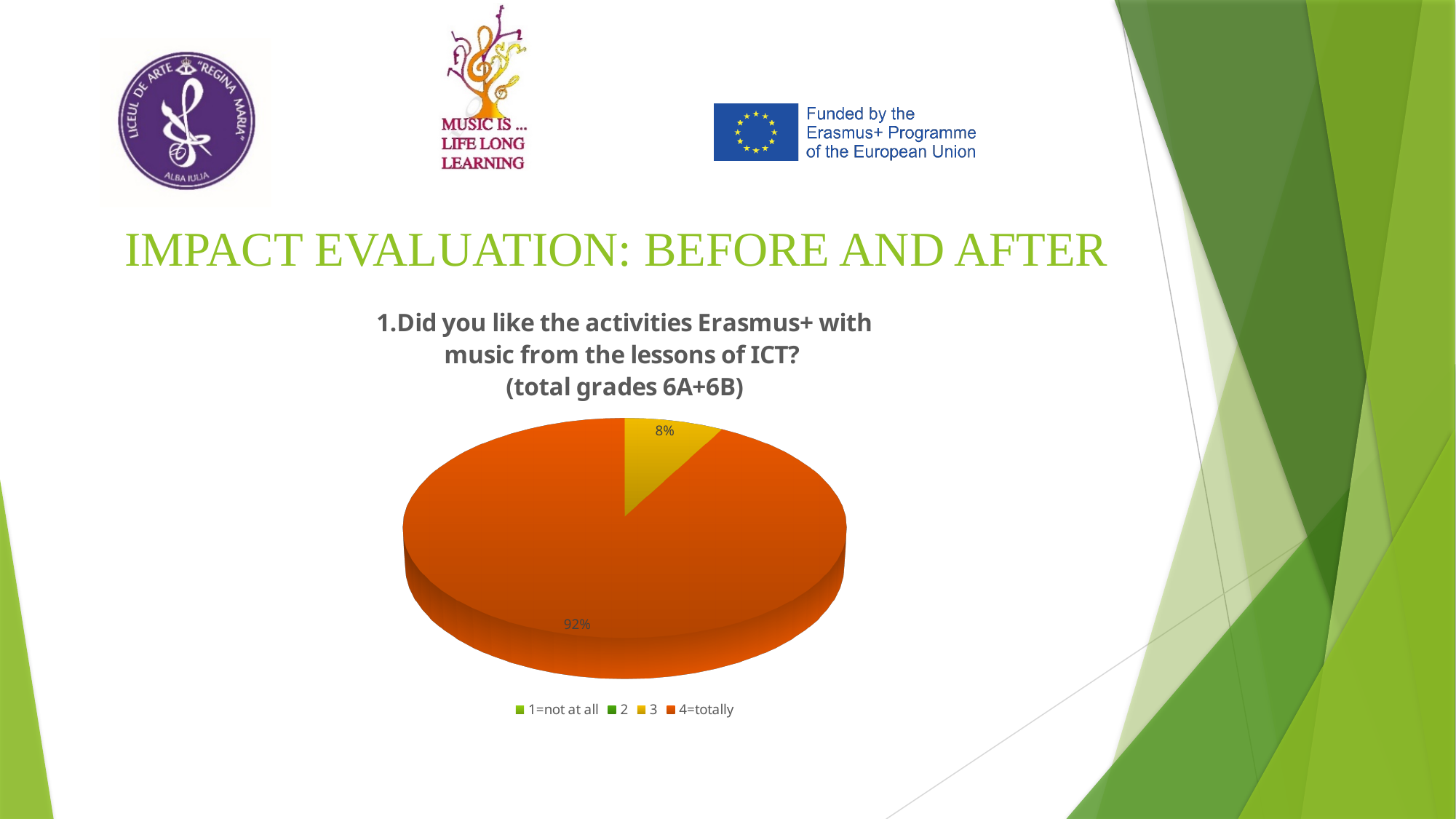
Is the share for "3" greater or less than 10%? less What colour is the "4=totally" slice? orange Is the share for "4=totally" greater or less than 50%? greater What is the title of the chart? 1.Did you like the activities Erasmus+ with music from the lessons of ICT? (total grades 6A+6B) Which category has the largest slice of the pie? 4=totally What kind of chart is shown on the slide? pie chart Which of the two visible slices is larger, "3" or "4=totally"? 4=totally How many categories does the legend list? 4 What share of the pie does the category "3" have? 8% What share of the pie does the category "4=totally" have? 92% What is the difference in percentage points between the "4=totally" slice and the "3" slice? 84